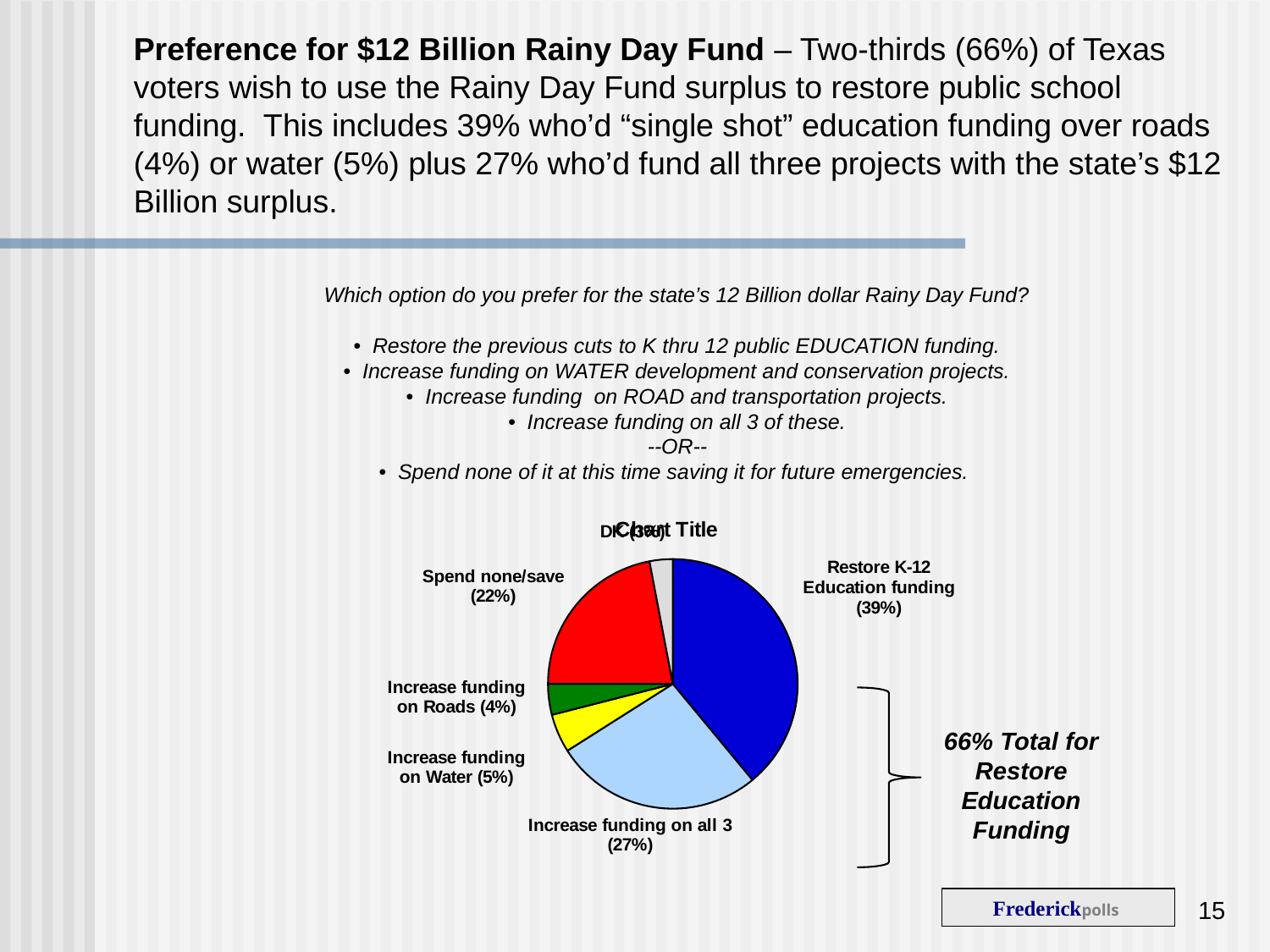
What is the combined share of 'Restore K-12 Education funding' and 'Increase funding on all 3'? 66% What share of the pie is 'Increase funding on Water'? 5% What share of the pie is 'Restore K-12 Education funding'? 39% Which is larger, the slice for 'Increase funding on Water' or the slice for 'Increase funding on Roads'? Increase funding on Water What share of the pie is 'Spend none/save'? 22% What colour is the 'Spend none/save' slice? red Which option has the largest slice of the pie? Restore K-12 Education funding What is the difference between the 'Restore K-12 Education funding' share and the 'Increase funding on all 3' share? 12% What kind of chart is shown on the slide? pie chart How many slices does the pie chart have? 6